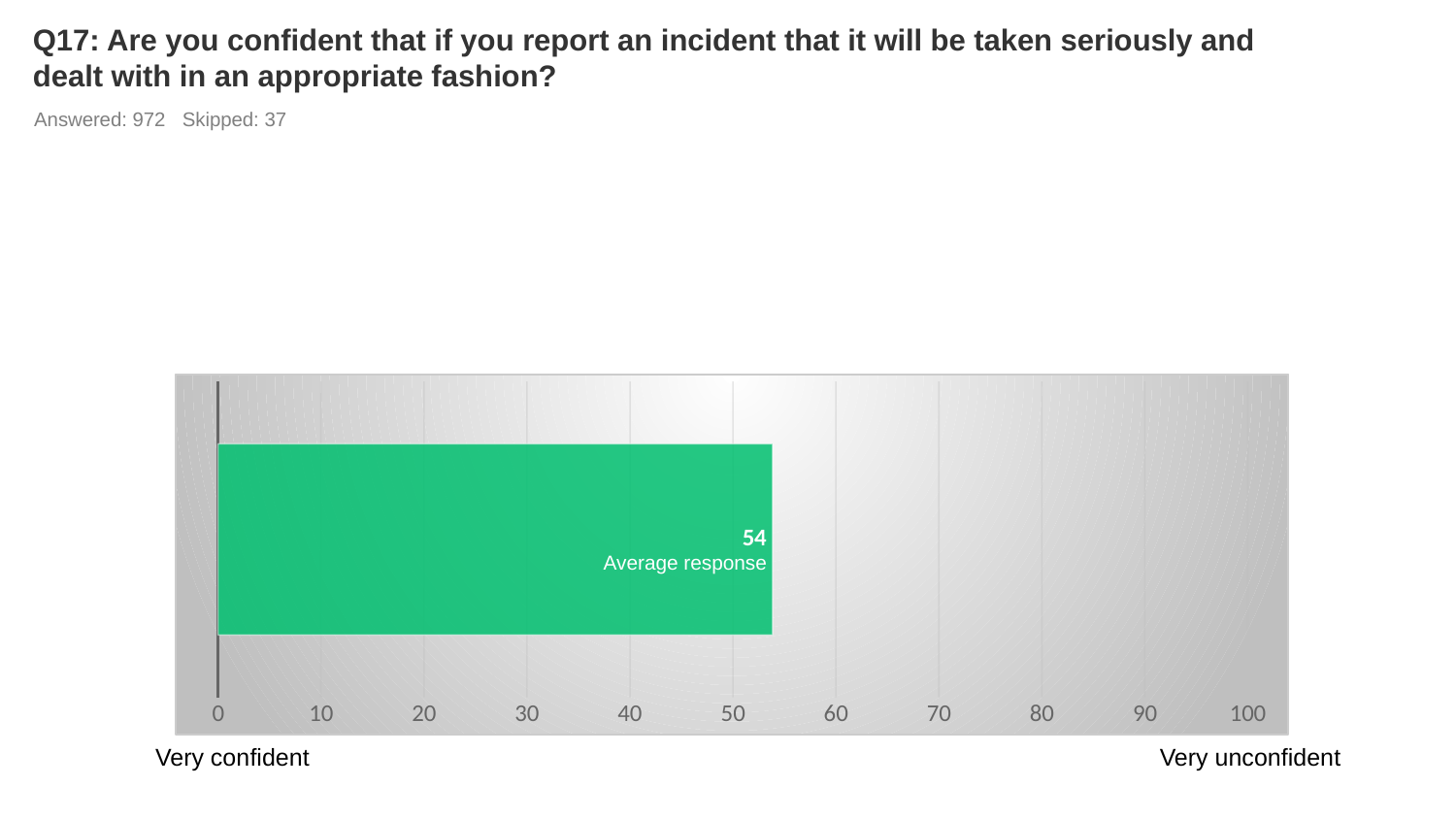
How many bars are plotted on the chart? 1 What label appears at the left end of the scale below the chart? Very confident What is the average response value shown on the chart? 54 How many respondents answered the question shown on the slide? 972 What is the maximum value shown on the horizontal axis? 100 What kind of chart is shown on the slide? bar chart How many respondents skipped the question shown on the slide? 37 Is the average response value greater or less than 50? greater Is the average response value greater or less than 60? less